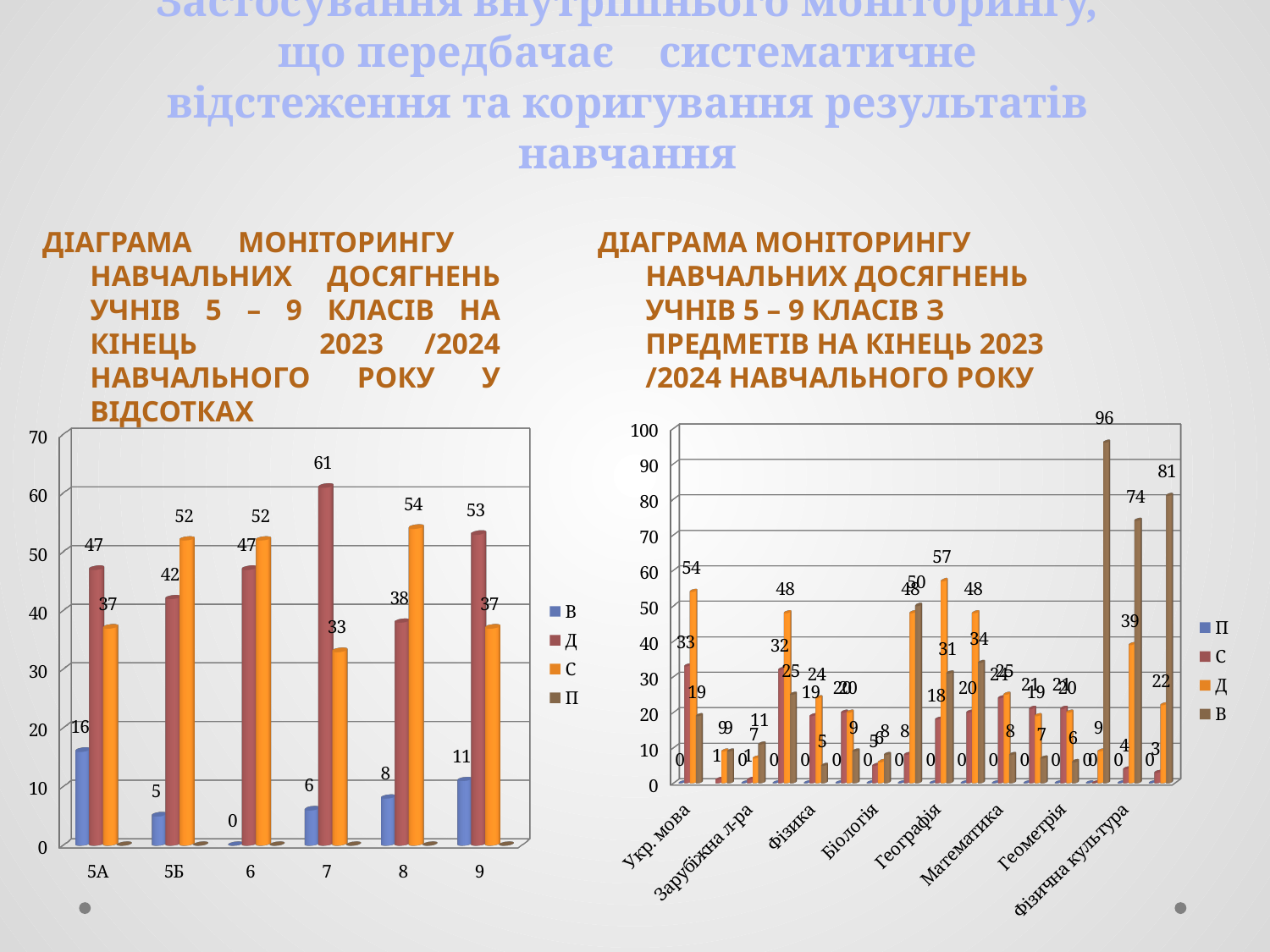
In the left chart, what is the difference between series Д and series С for class 7? 28 In the right chart, what is the highest value labeled on any bar? 96 How many series does the legend of the left chart list? 4 In the left chart, which class has the lowest value for series В? 6 How many classes are shown on the x axis of the left chart? 6 In the left chart, which class has the highest value for series Д? 7 In the left chart, what is the value of series С for class 5Б? 52 In the left chart, what is the value of series С for class 8? 54 In the left chart, what is the value of series В for class 5А? 16 What type of chart is the right chart (ДІАГРАМА МОНІТОРИНГУ ... З ПРЕДМЕТІВ)? bar chart In the left chart (ДІАГРАМА МОНІТОРИНГУ ... У ВІДСОТКАХ), what is the value of series Д for class 7? 61 In the left chart, for class 8, which is larger: series Д or series С? С